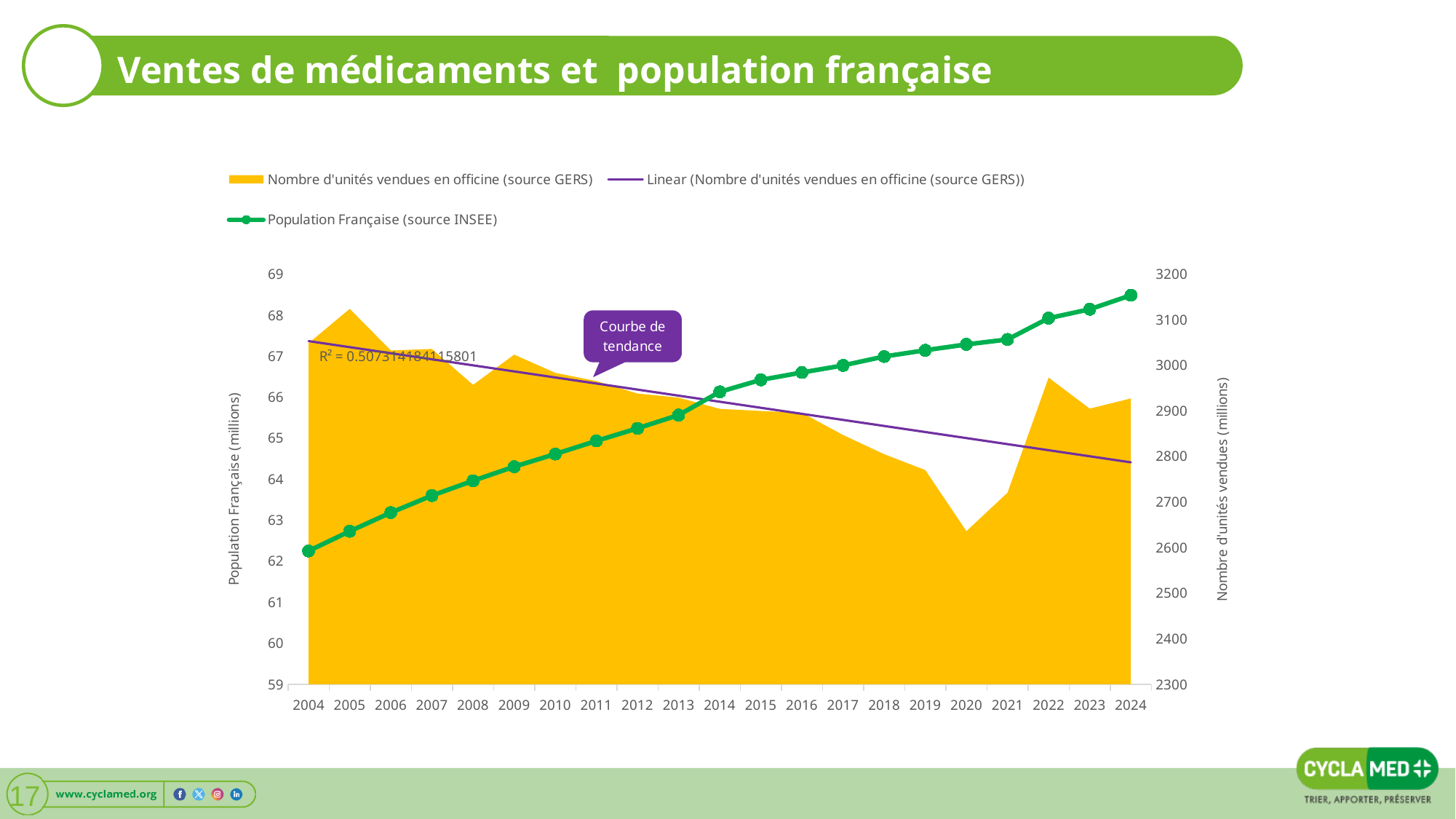
What kind of chart is shown on the slide? A combined area and line chart In which year is the Population Française (source INSEE) value highest? 2024 Does the Population Française (source INSEE) series rise or fall from 2004 to 2024? Rises Is the Population Française value for 2004 greater or less than 63? less Is the Nombre d'unités vendues en officine value for 2020 greater or less than 2700? less What R² value is printed on the chart for the trend line? R² = 0.507314184115801 How many years are shown on the x axis of the chart? 21 In which year is the Population Française (source INSEE) value lowest? 2004 In which year is the Nombre d'unités vendues en officine (source GERS) value lowest? 2020 How many series does the chart legend list? 3 Is the Population Française value for 2024 greater or less than 68? greater Which year has the larger Nombre d'unités vendues en officine value, 2020 or 2022? 2022